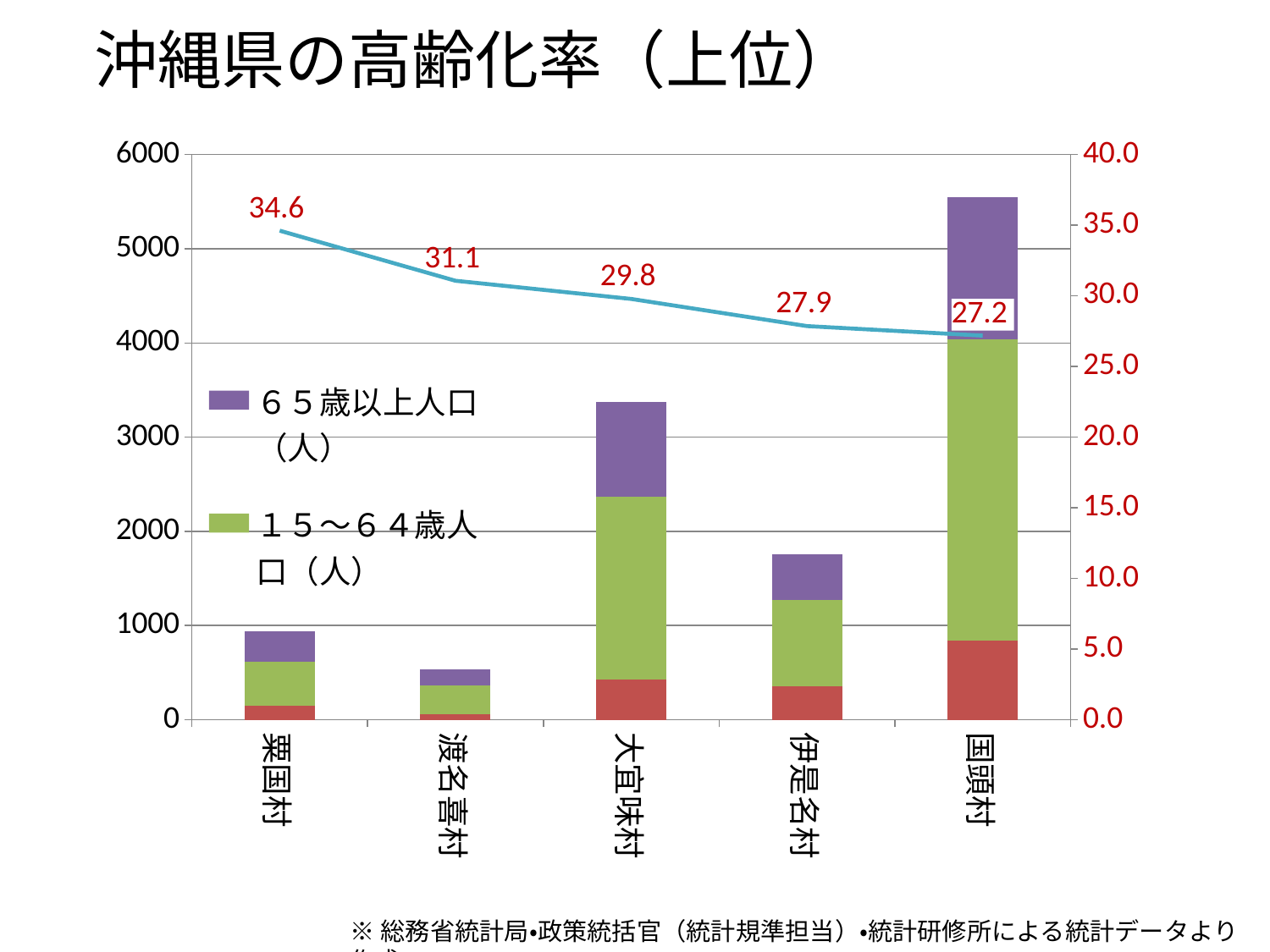
What is the difference between the line values for 粟国村 and 渡名喜村? 3.5 Which village has the highest line value? 粟国村 What is the title of the slide? 沖縄県の高齢化率（上位） Do the line values rise or fall from left to right along the x axis? fall What is the value of the line for 国頭村? 27.2 What is the value of the line (高齢化率) for 粟国村? 34.6 Is the total stacked bar for 国頭村 greater or less than 5000? greater Which village has the lowest line value? 国頭村 Which village has the tallest stacked bar? 国頭村 What is the value of the line for 大宜味村? 29.8 Is the total stacked bar for 渡名喜村 greater or less than 1000? less How many villages are shown on the x axis? 5